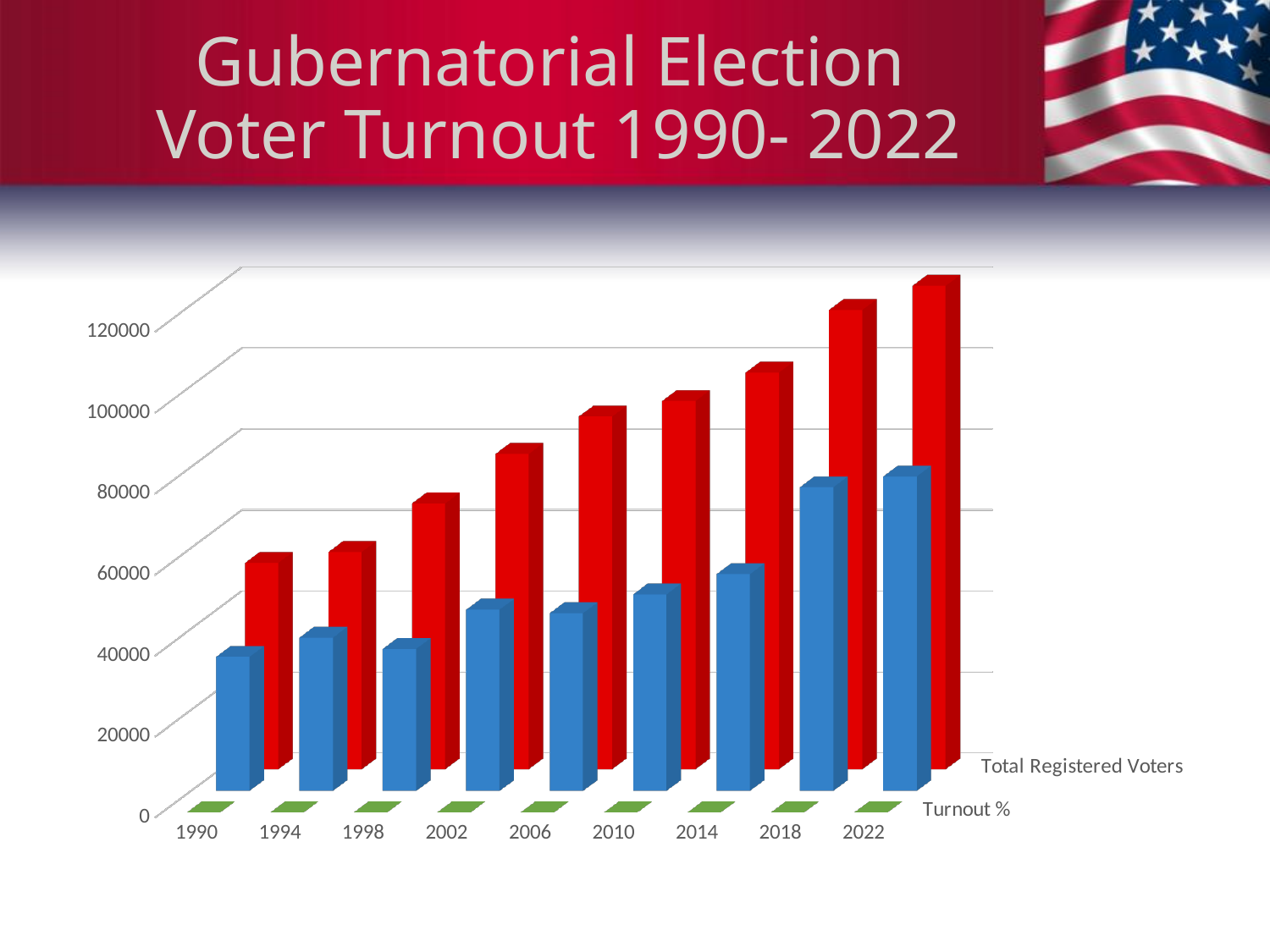
What is the title of the slide? Gubernatorial Election Voter Turnout 1990- 2022 Which year has the lowest value for Total Registered Voters? 1990 Does the value for Total Registered Voters rise or fall from 1990 to 2022? rise What type of chart is shown on the slide? Bar chart Which year has the highest value for Total Registered Voters? 2022 Which is larger, Total Registered Voters in 2018 or in 1994? 2018 How many election years are shown on the x axis? 9 Is the value for Total Registered Voters in 1990 greater or less than 80000? less Which colour are the Total Registered Voters bars? Red